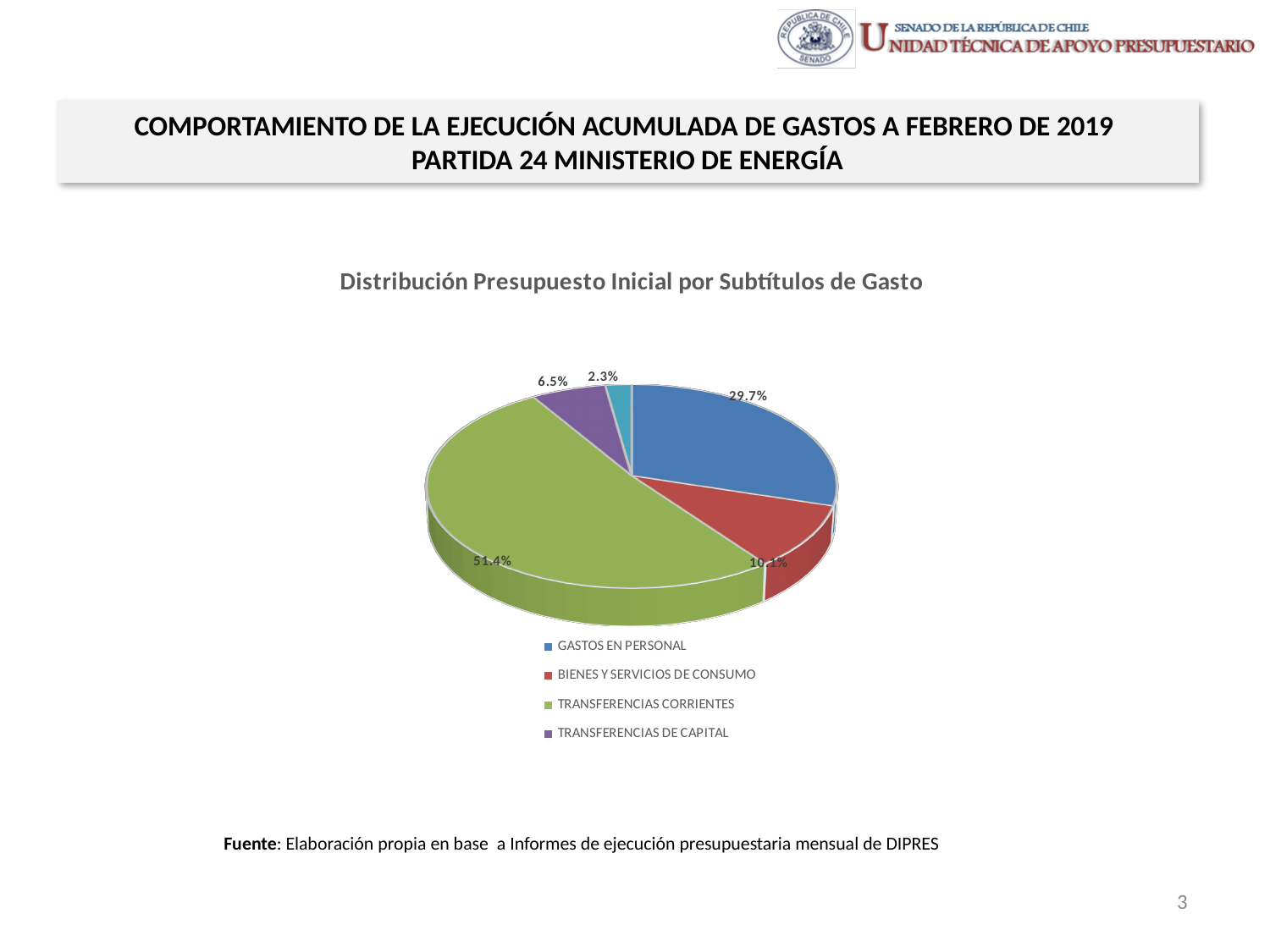
What is the smallest percentage shown on the pie chart? 2.3% What kind of chart is shown on the slide? Pie chart Which category has the largest share of the pie? TRANSFERENCIAS CORRIENTES How many entries does the legend list? 4 What share of the pie does TRANSFERENCIAS CORRIENTES represent? 51.4% Which is larger, the share for BIENES Y SERVICIOS DE CONSUMO or the share for TRANSFERENCIAS DE CAPITAL? BIENES Y SERVICIOS DE CONSUMO How many slices does the pie chart have? 5 What share of the pie does BIENES Y SERVICIOS DE CONSUMO represent? 10.1% What is the difference in percentage points between TRANSFERENCIAS CORRIENTES and GASTOS EN PERSONAL? 21.7 What share of the pie does TRANSFERENCIAS DE CAPITAL represent? 6.5% What is the title of the chart? Distribución Presupuesto Inicial por Subtítulos de Gasto